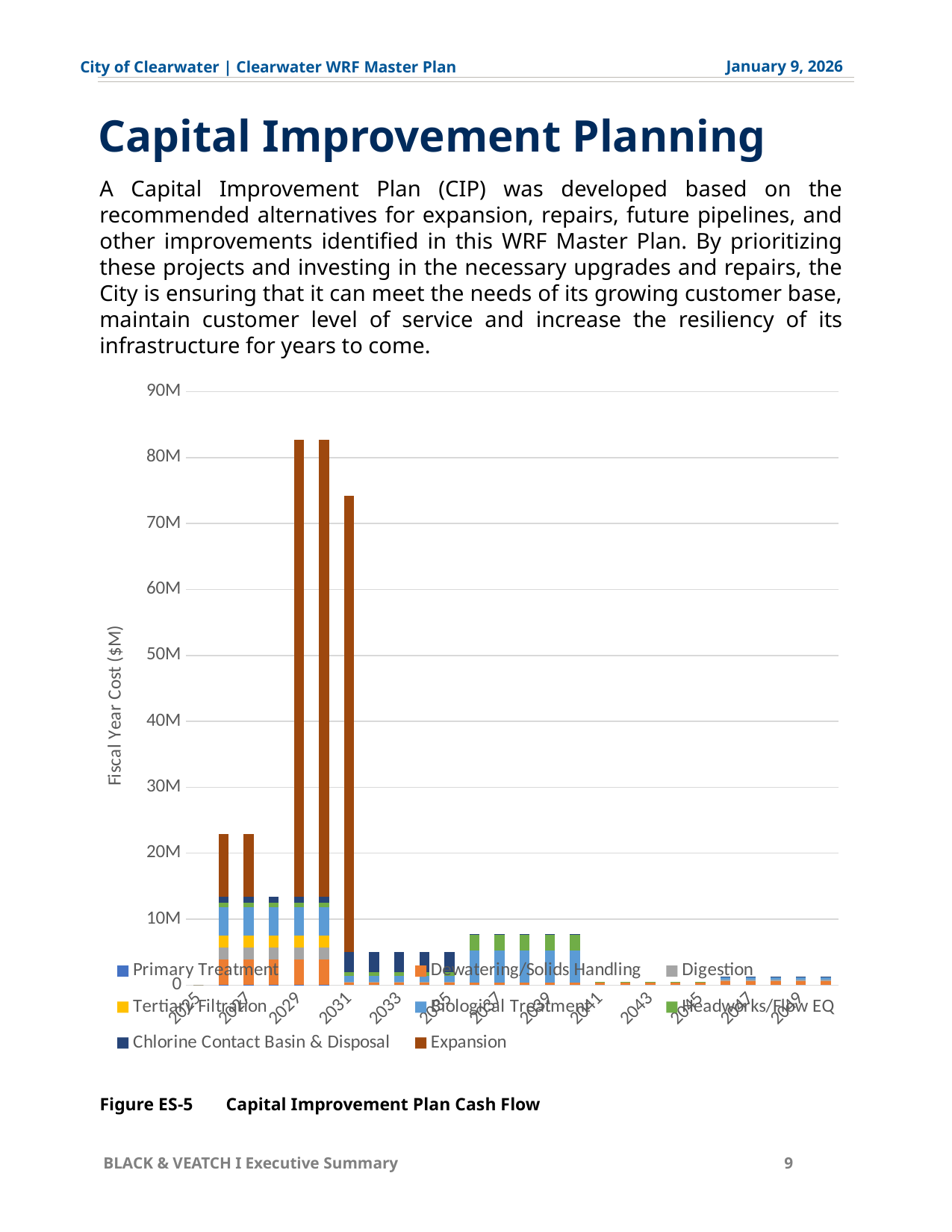
How many series does the legend of the Capital Improvement Plan Cash Flow chart list? 8 Is the value of the bar for 2049 greater or less than 10M? less Which series makes up almost all of the three tallest bars in the chart? Expansion What is the caption of the figure shown on the slide? Figure ES-5 Capital Improvement Plan Cash Flow Is the value of the tallest bar in the chart greater or less than 80M? greater What is the highest value shown on the vertical axis of the chart? 90M What is the label on the vertical axis of the chart? Fiscal Year Cost ($M) Is the value of the bar for 2031 greater or less than 70M? greater What kind of chart is shown in Figure ES-5? Stacked bar chart Do the bar values generally rise or fall after 2031 along the x axis? fall How many year labels are shown on the x axis of the chart? 13